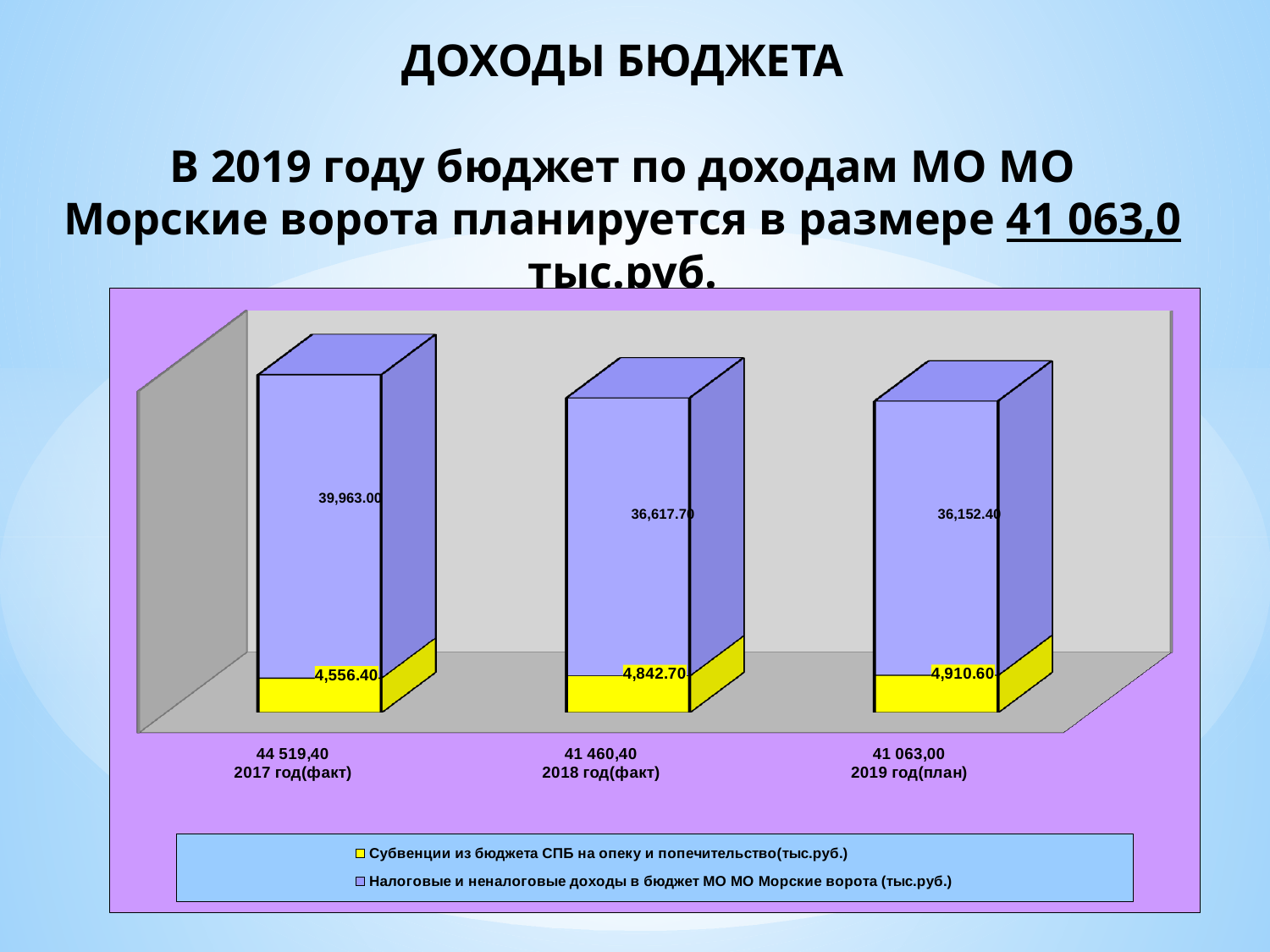
How many series does the legend list? 2 What is the total of the stacked bar for 2018 год(факт)? 41 460,40 Which year has the lowest value for 'Субвенции из бюджета СПБ на опеку и попечительство'? 2017 год(факт) Which year has the highest value for 'Налоговые и неналоговые доходы'? 2017 год(факт) Is the 'Субвенции' value larger for 2018 год(факт) or for 2019 год(план)? 2019 год(план) What is the difference between the 'Налоговые и неналоговые доходы' values for 2017 год(факт) and 2019 год(план)? 3,810.60 Do the 'Налоговые и неналоговые доходы' values rise or fall from 2017 to 2019? Fall What is the value of 'Налоговые и неналоговые доходы' for 2018 год(факт)? 36,617.70 What is the value of 'Субвенции из бюджета СПБ на опеку и попечительство' for 2019 год(план)? 4,910.60 What is the value of 'Налоговые и неналоговые доходы' for 2017 год(факт)? 39,963.00 What kind of chart is shown on the slide? Stacked bar chart How many bars (years) are plotted in the chart? 3